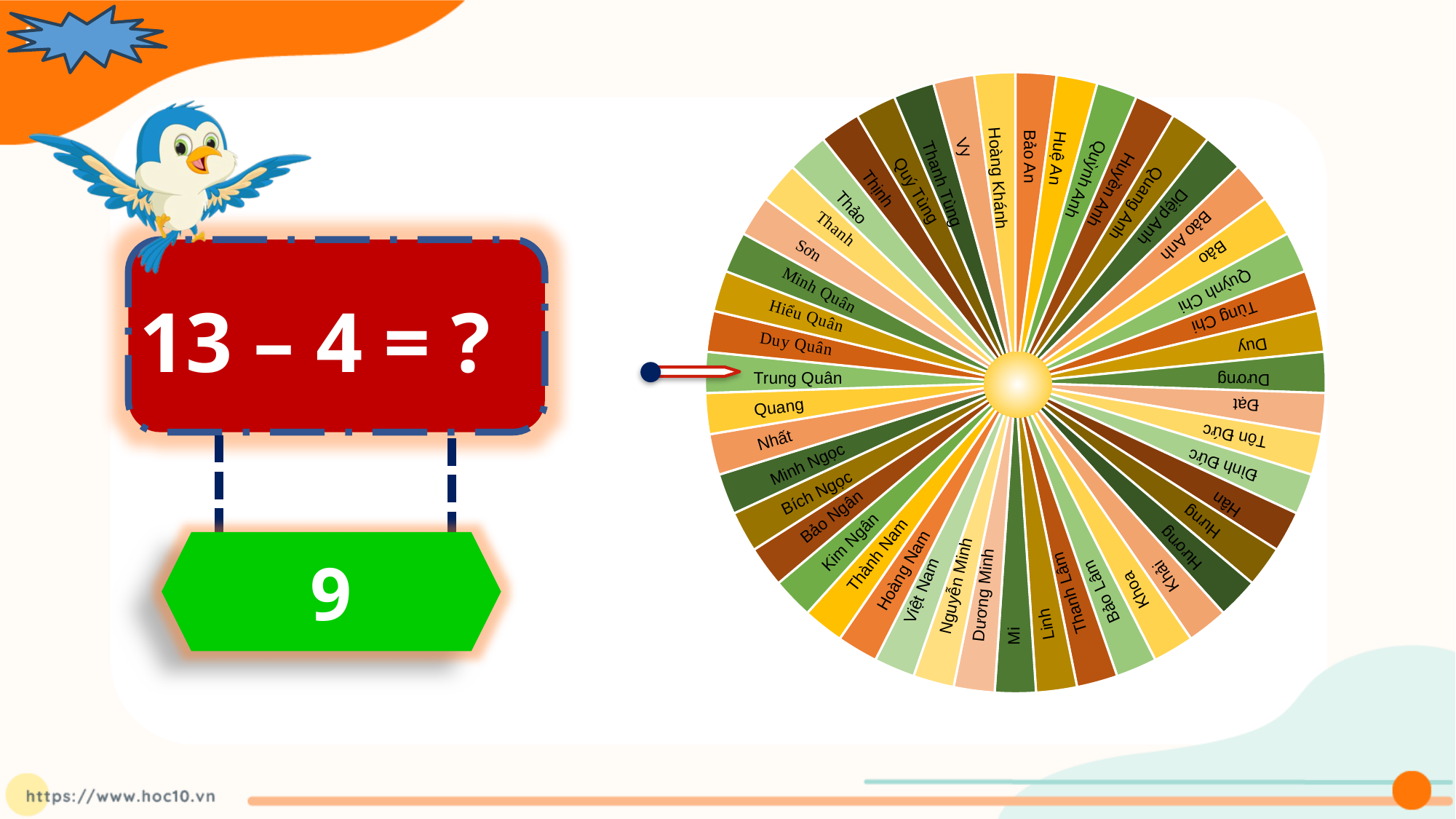
How many name slices does the wheel contain? 47 Which name on the wheel does the arrow on the left point to? Trung Quân Which name is on the slice between Bảo Lâm and Linh on the wheel? Thanh Lâm Which name appears on the slice directly counter-clockwise from Trung Quân on the wheel? Quang Are the slices of the wheel all the same size or different sizes? the same size Which name appears on the slice directly clockwise from Trung Quân on the wheel? Duy Quân What kind of chart is the wheel on the right side of the slide? pie chart Which name is on the slice at the very top of the wheel, just left of Bảo An? Hoàng Khánh